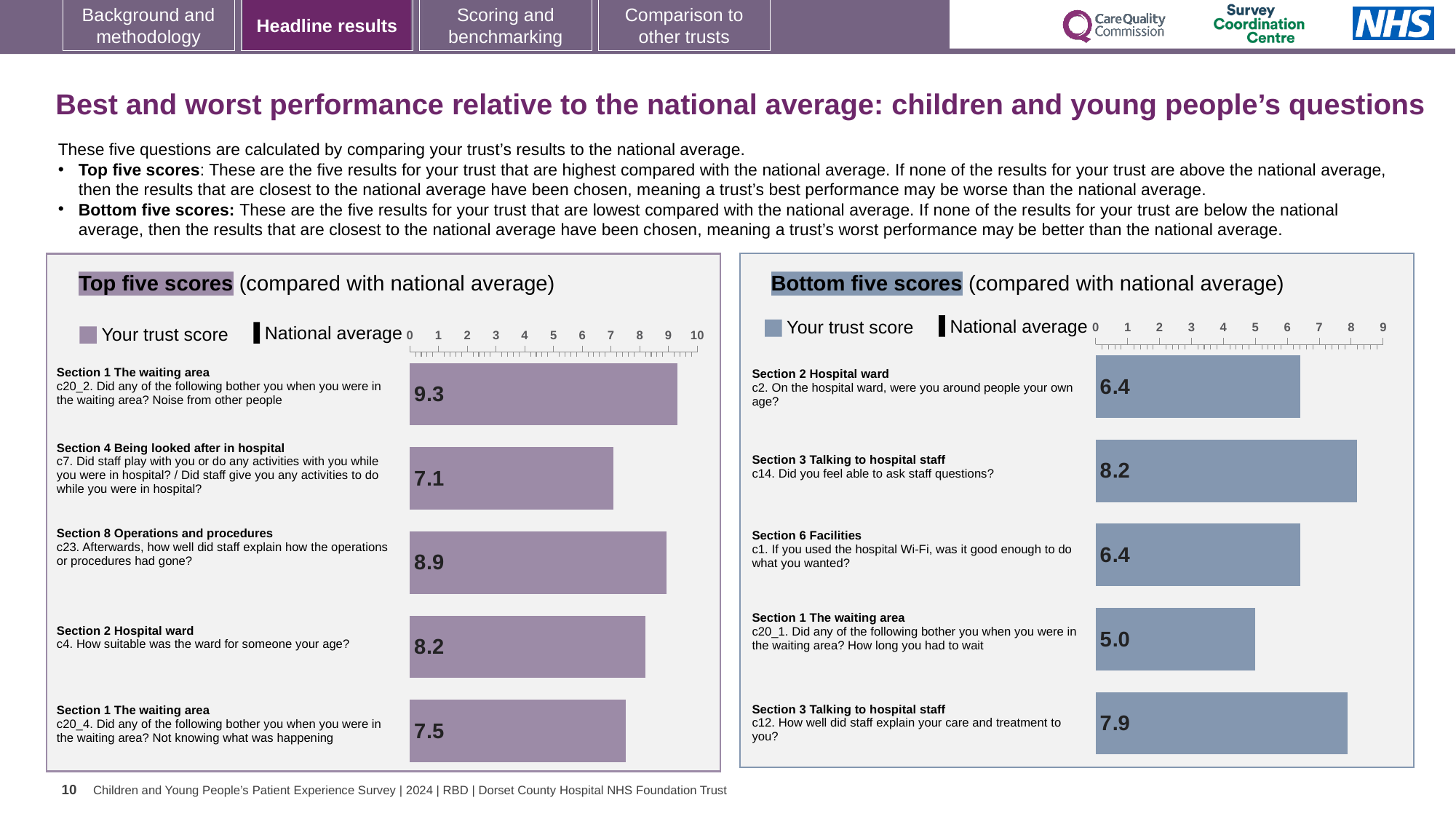
In the Top five scores chart, what is the trust score for c20_2 (noise from other people in the waiting area)? 9.3 In the Top five scores chart, what is the difference between the trust scores for c20_2 and c7? 2.2 In the Bottom five scores chart, what is the trust score for c14 (Did you feel able to ask staff questions?)? 8.2 What kind of chart is the Top five scores chart? Bar chart In the Bottom five scores chart, which question has the lowest trust score? c20_1 (how long you had to wait in the waiting area) In the Bottom five scores chart, what is the difference between the trust scores for c14 and c20_1? 3.2 How many series does the legend of the Bottom five scores chart list? 2 How many questions are plotted in the Top five scores chart? 5 In the Top five scores chart, is the trust score for c23 (how well staff explained how operations had gone) greater or less than 8? greater In the Bottom five scores chart, which has the larger trust score: c12 (How well did staff explain your care and treatment) or c2 (around people your own age)? c12 In the Top five scores chart, what is the trust score for c4 (How suitable was the ward for someone your age?)? 8.2 In the Top five scores chart, which question has the highest trust score? c20_2 (noise from other people in the waiting area)